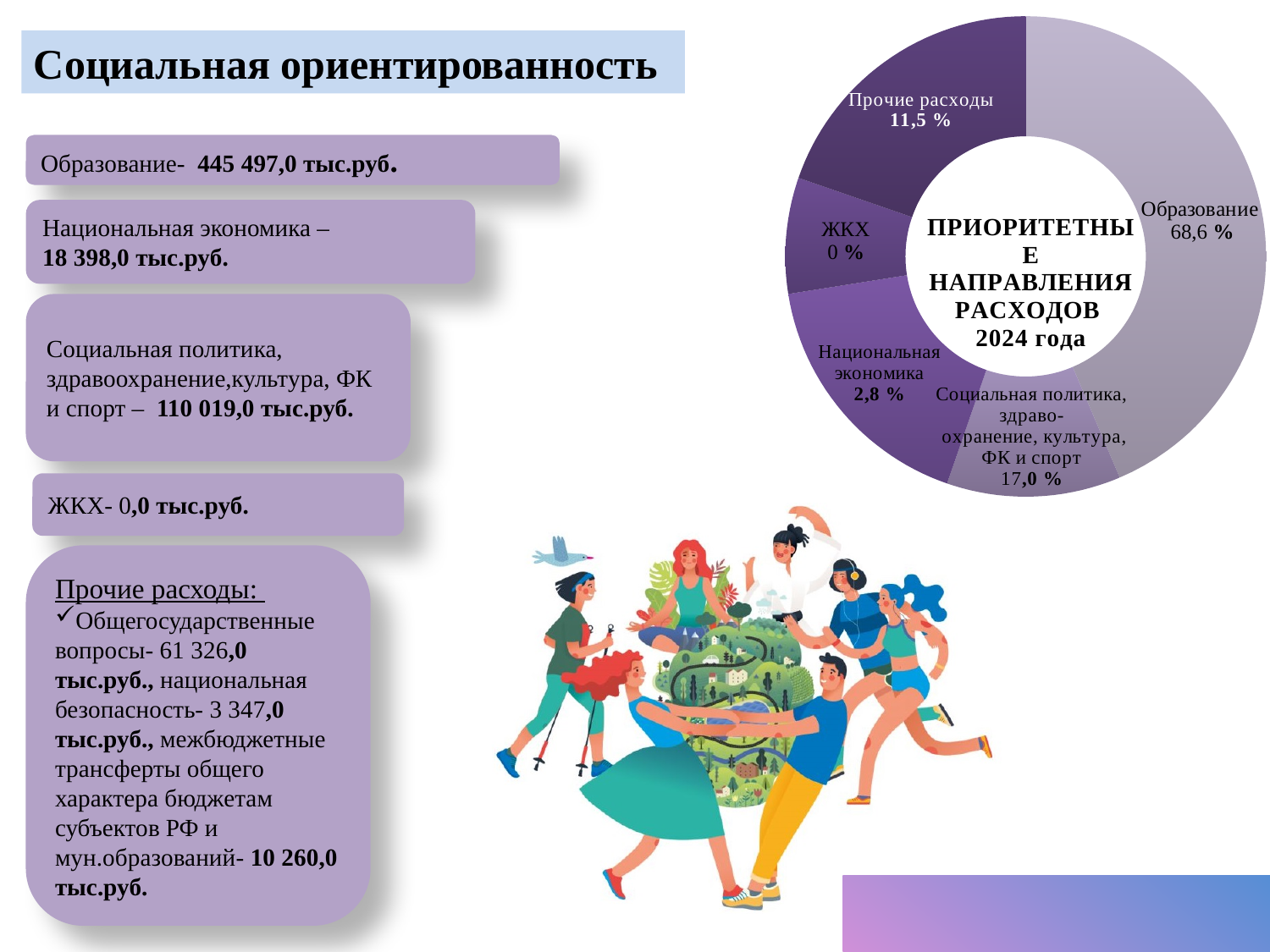
What percentage is shown for Национальная экономика (national economy) in the pie chart? 2,8 % What title is written in the centre of the pie chart? ПРИОРИТЕТНЫЕ НАПРАВЛЕНИЯ РАСХОДОВ 2024 года What is the difference in percentage points between Образование and Прочие расходы in the pie chart? 57,1 Which category has the smallest share in the pie chart? ЖКХ Which category has the largest share in the pie chart? Образование What share does the slice 'Социальная политика, здравоохранение, культура, ФК и спорт' have in the pie chart? 17,0 % What percentage is shown for ЖКХ in the pie chart? 0 % How many categories (slices) are labelled in the pie chart? 5 What share of the pie chart does Образование (education) account for? 68,6 % What type of chart is shown on the slide? Pie (doughnut) chart What percentage is shown for Прочие расходы (other expenses) in the pie chart? 11,5 % Which is larger in the pie chart: Прочие расходы or Национальная экономика? Прочие расходы